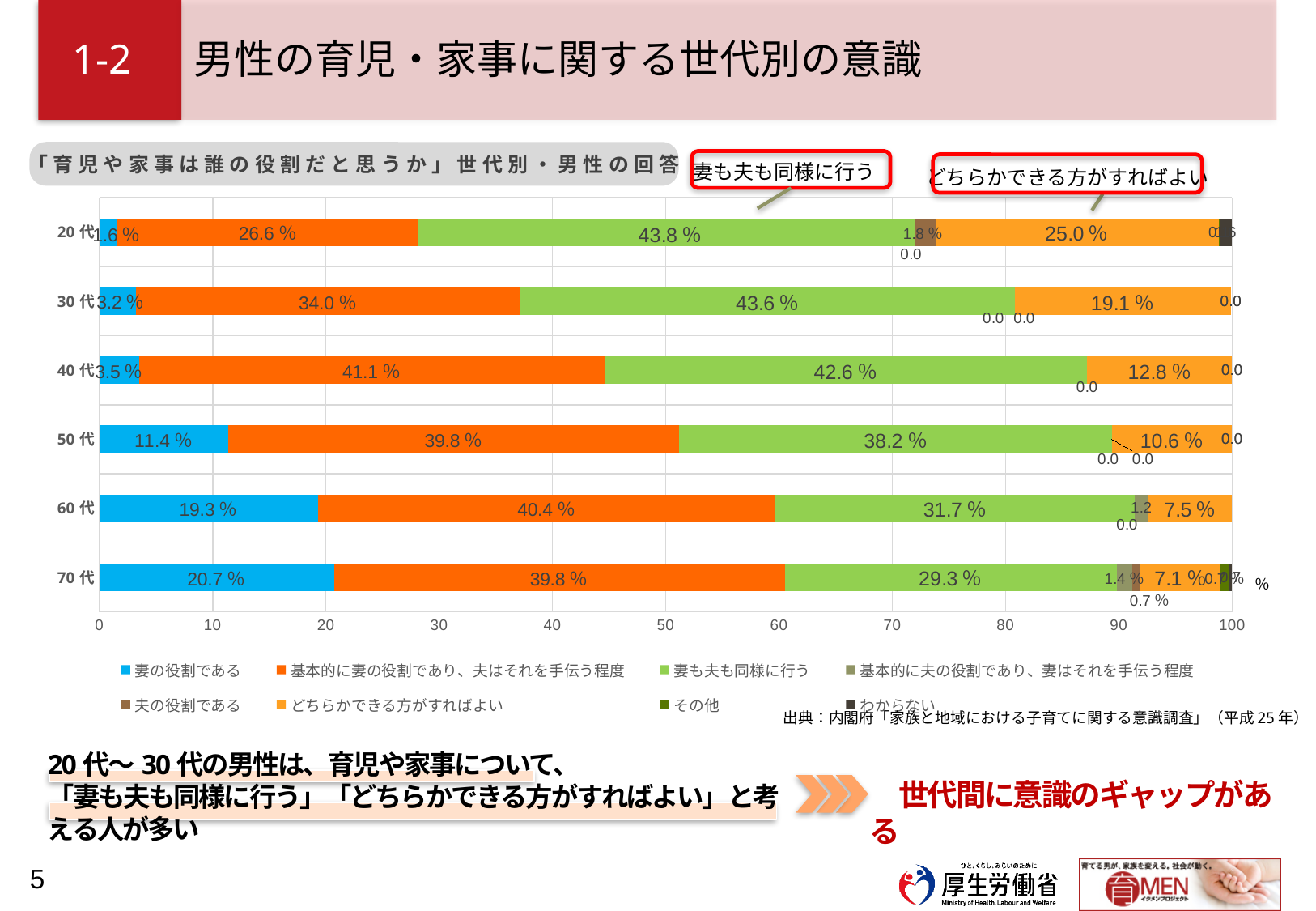
Does the value for 妻の役割である rise or fall from 20代 to 70代? Rises What is the value for 基本的に妻の役割であり、夫はそれを手伝う程度 in the 40代 bar? 41.1 % Which age group has the lowest value for どちらかできる方がすればよい? 70代 In the 30代 bar, which is larger: 妻も夫も同様に行う or 基本的に妻の役割であり、夫はそれを手伝う程度? 妻も夫も同様に行う What kind of chart is shown on the slide? Stacked bar chart What is the value for 妻の役割である in the 70代 bar? 20.7 % How many series does the legend list? 8 What is the value for 妻も夫も同様に行う in the 60代 bar? 31.7 % How many age groups are shown in the chart? 6 What is the value for 妻も夫も同様に行う in the 20代 bar? 43.8 % What is the difference between the どちらかできる方がすればよい values for 20代 and 50代? 14.4 % Which age group has the highest value for 妻の役割である? 70代